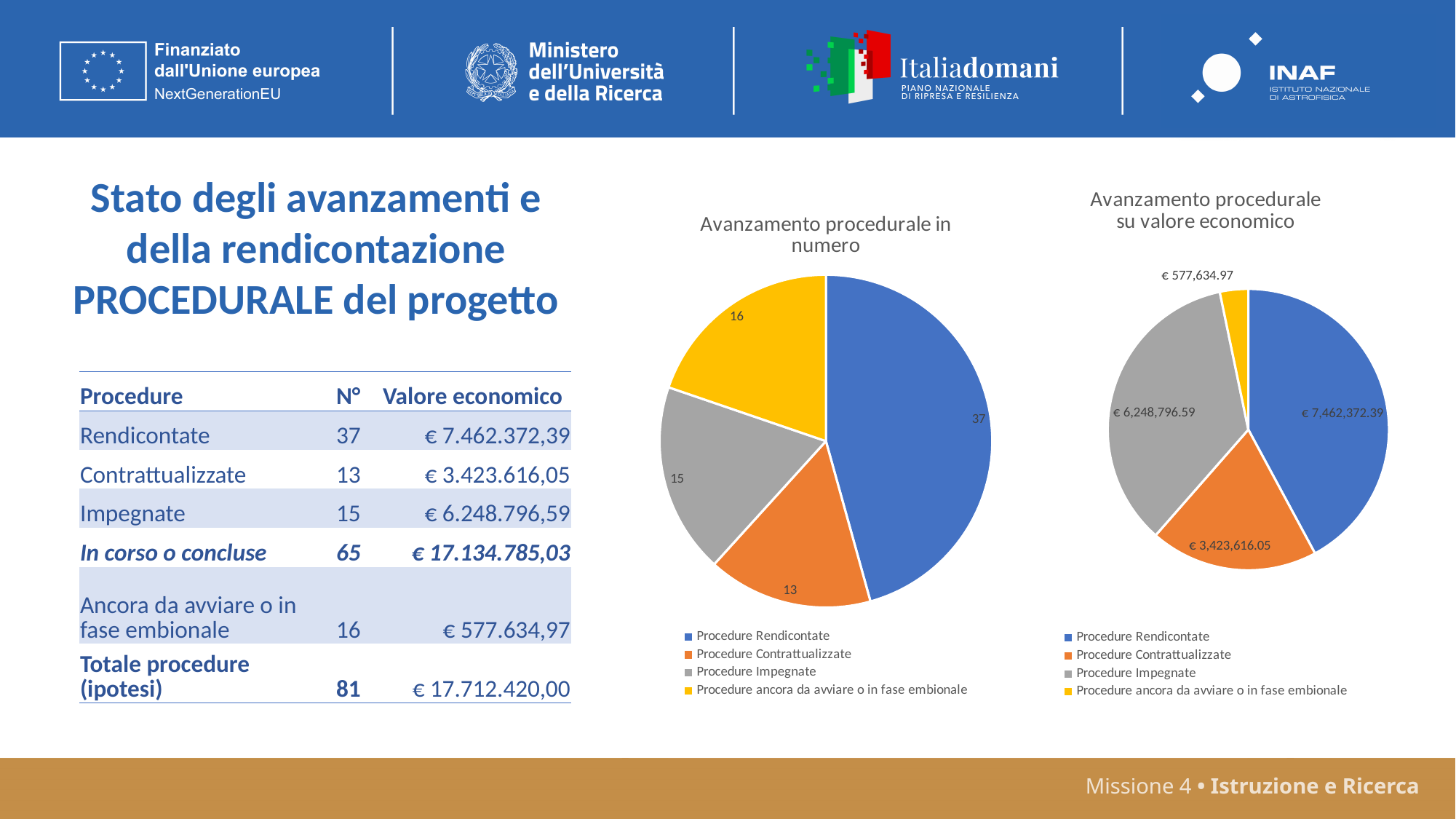
How many entries does the legend of the chart "Avanzamento procedurale su valore economico" list? 4 What type of chart is "Avanzamento procedurale in numero"? Pie chart In the chart "Avanzamento procedurale in numero", what is the difference between Procedure Rendicontate and Procedure Contrattualizzate? 24 In the chart "Avanzamento procedurale in numero", how many slices does the pie have? 4 In the chart "Avanzamento procedurale su valore economico", what is the value for Procedure ancora da avviare o in fase embionale? € 577,634.97 In the chart "Avanzamento procedurale in numero", what is the value for Procedure Impegnate? 15 In the chart "Avanzamento procedurale su valore economico", which category has the largest slice? Procedure Rendicontate In the chart "Avanzamento procedurale su valore economico", what is the difference between Procedure Rendicontate and Procedure Impegnate? € 1,213,575.80 In the chart "Avanzamento procedurale su valore economico", which is larger: Procedure Contrattualizzate or Procedure Impegnate? Procedure Impegnate In the chart "Avanzamento procedurale su valore economico", what is the value for Procedure Impegnate? € 6,248,796.59 In the chart "Avanzamento procedurale in numero", what is the value for Procedure Rendicontate? 37 In the chart "Avanzamento procedurale in numero", which category has the smallest slice? Procedure Contrattualizzate